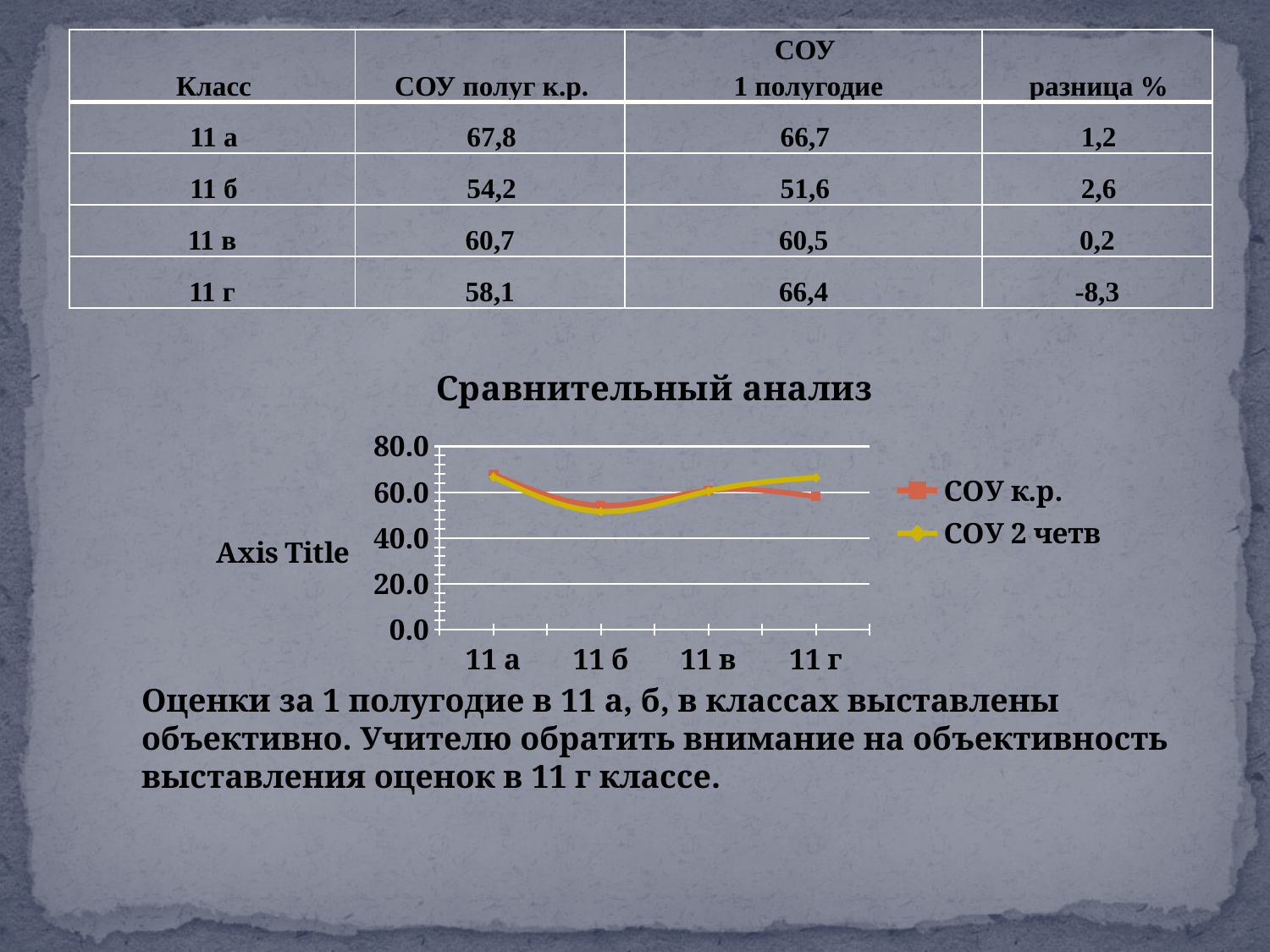
Does the СОУ к.р. line rise or fall from 11 а to 11 б? fall Is the value of СОУ к.р. for 11 а greater or less than 60? greater At 11 г, which series has the larger value, СОУ к.р. or СОУ 2 четв? СОУ 2 четв Is the value of СОУ 2 четв for 11 б greater or less than 60? less For the series СОУ к.р., which class has the highest value? 11 а How many categories are shown on the x axis of the chart? 4 For the series СОУ 2 четв, which class has the lowest value? 11 б Does the СОУ 2 четв line rise or fall from 11 в to 11 г? rise What is the title of the chart? Сравнительный анализ How many series does the chart legend list? 2 What kind of chart is shown on the slide? line chart Which series in the chart is drawn in yellow? СОУ 2 четв